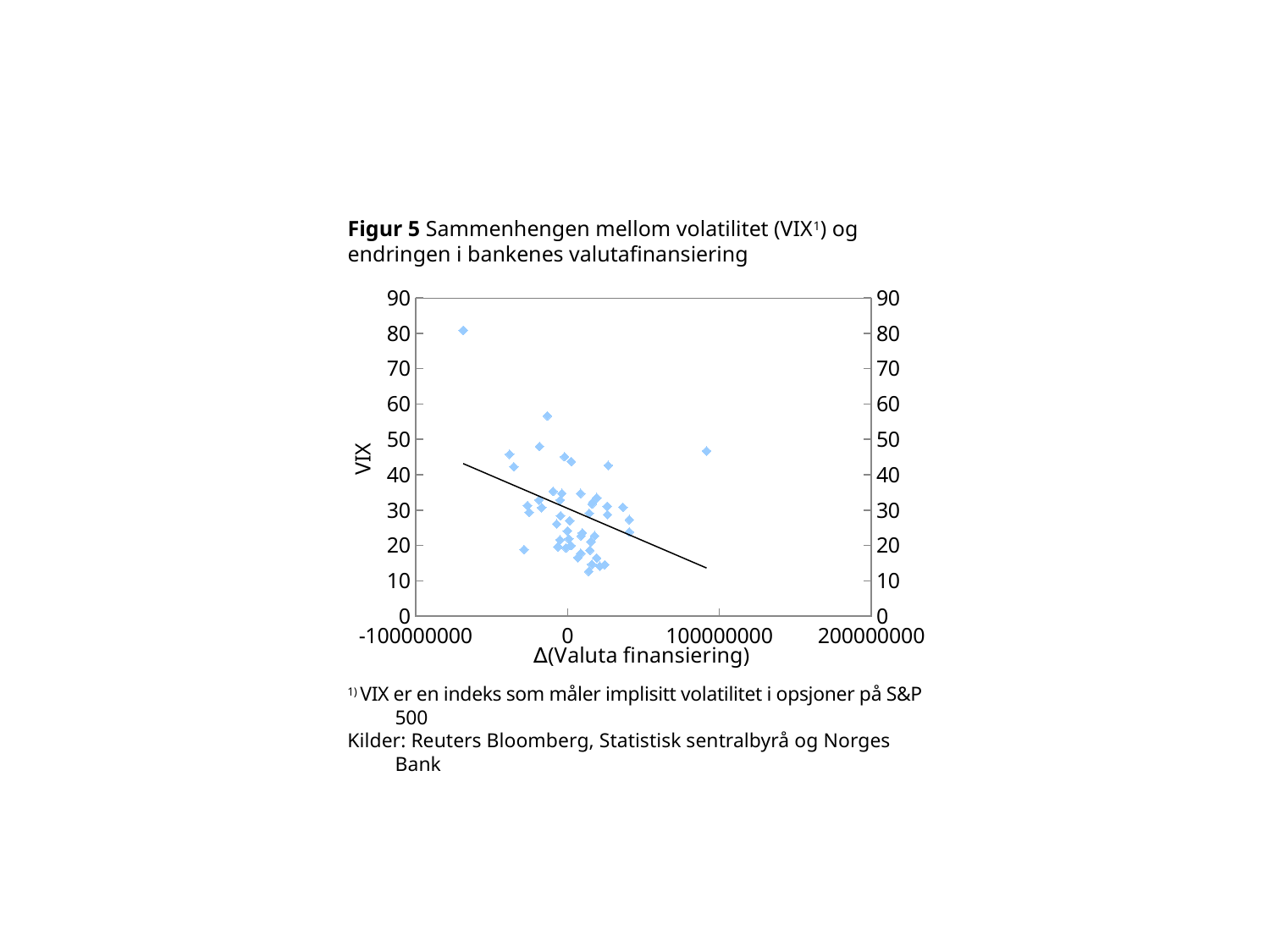
What is the highest value shown on the VIX axis in Figur 5? 90 What kind of chart is shown in Figur 5? scatter chart Is the VIX value of the highest point in Figur 5 greater or less than 70? greater Is the VIX value of the rightmost point in Figur 5 greater or less than 40? greater Is the VIX value of the lowest point in Figur 5 greater or less than 20? less What is the highest value shown on the horizontal axis in Figur 5? 200000000 What is the label of the horizontal axis in Figur 5? Δ(Valuta finansiering) What is the label of the vertical axis in Figur 5? VIX Does the fitted trend line in Figur 5 rise or fall as Δ(Valuta finansiering) increases? fall What is the lowest value shown on the horizontal axis in Figur 5? -100000000